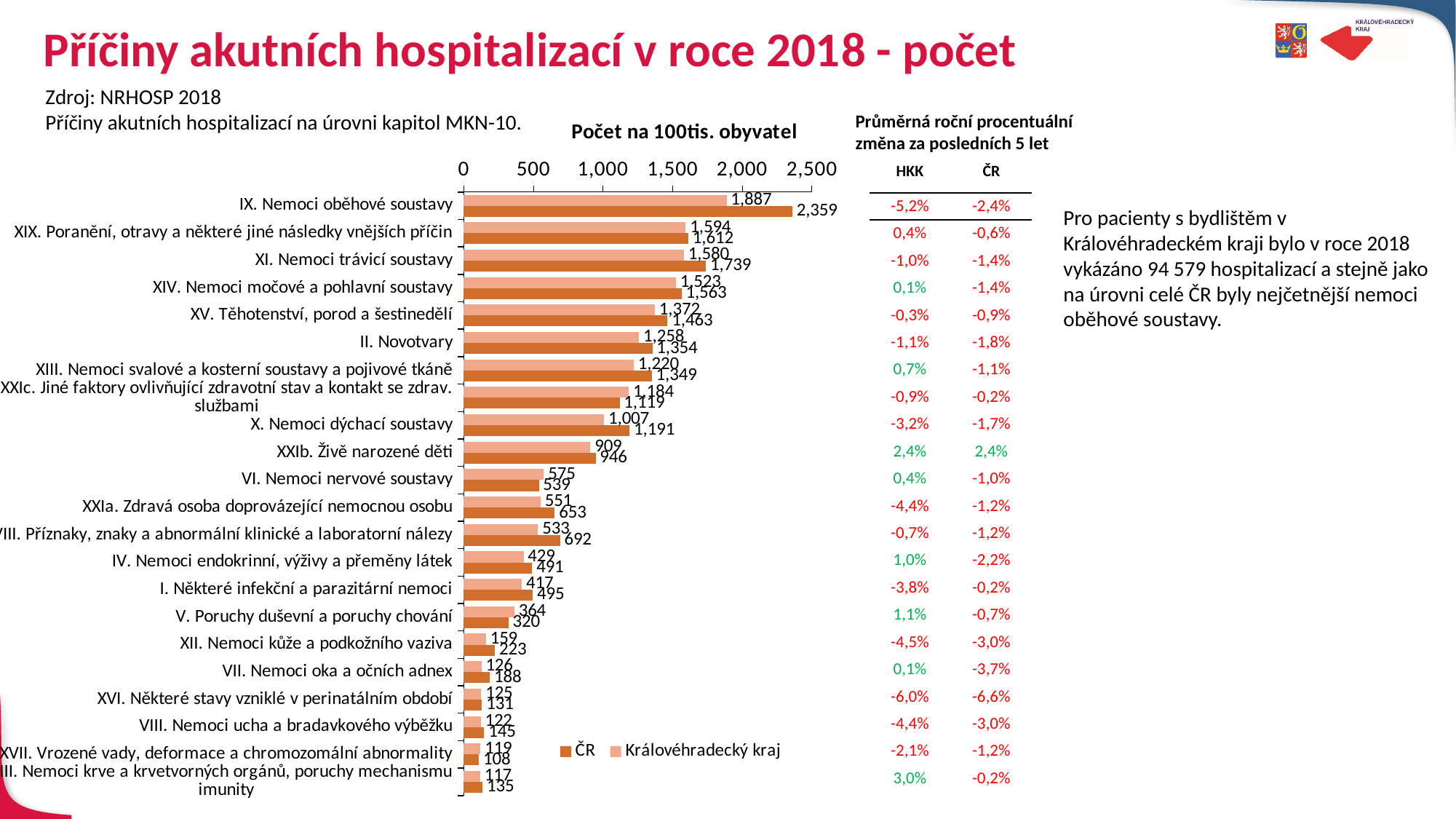
Which category has the lowest value for ČR? XVII. Vrozené vady, deformace a chromozomální abnormality What is the value for ČR for XXIb. Živě narozené děti? 946 What is the value for Královéhradecký kraj for XI. Nemoci trávicí soustavy? 1,580 What is the value for ČR for IX. Nemoci oběhové soustavy? 2,359 How many categories are shown in the bar chart? 22 What is the difference between the ČR and Královéhradecký kraj values for IX. Nemoci oběhové soustavy? 472 Is the ČR value for X. Nemoci dýchací soustavy greater or less than 1,000? greater For V. Poruchy duševní a poruchy chování, which series has the larger value, ČR or Královéhradecký kraj? Královéhradecký kraj How many series does the legend list? 2 What type of chart is shown on the slide? bar chart Which category has the highest value for Královéhradecký kraj? IX. Nemoci oběhové soustavy What is the title of the chart? Počet na 100tis. obyvatel